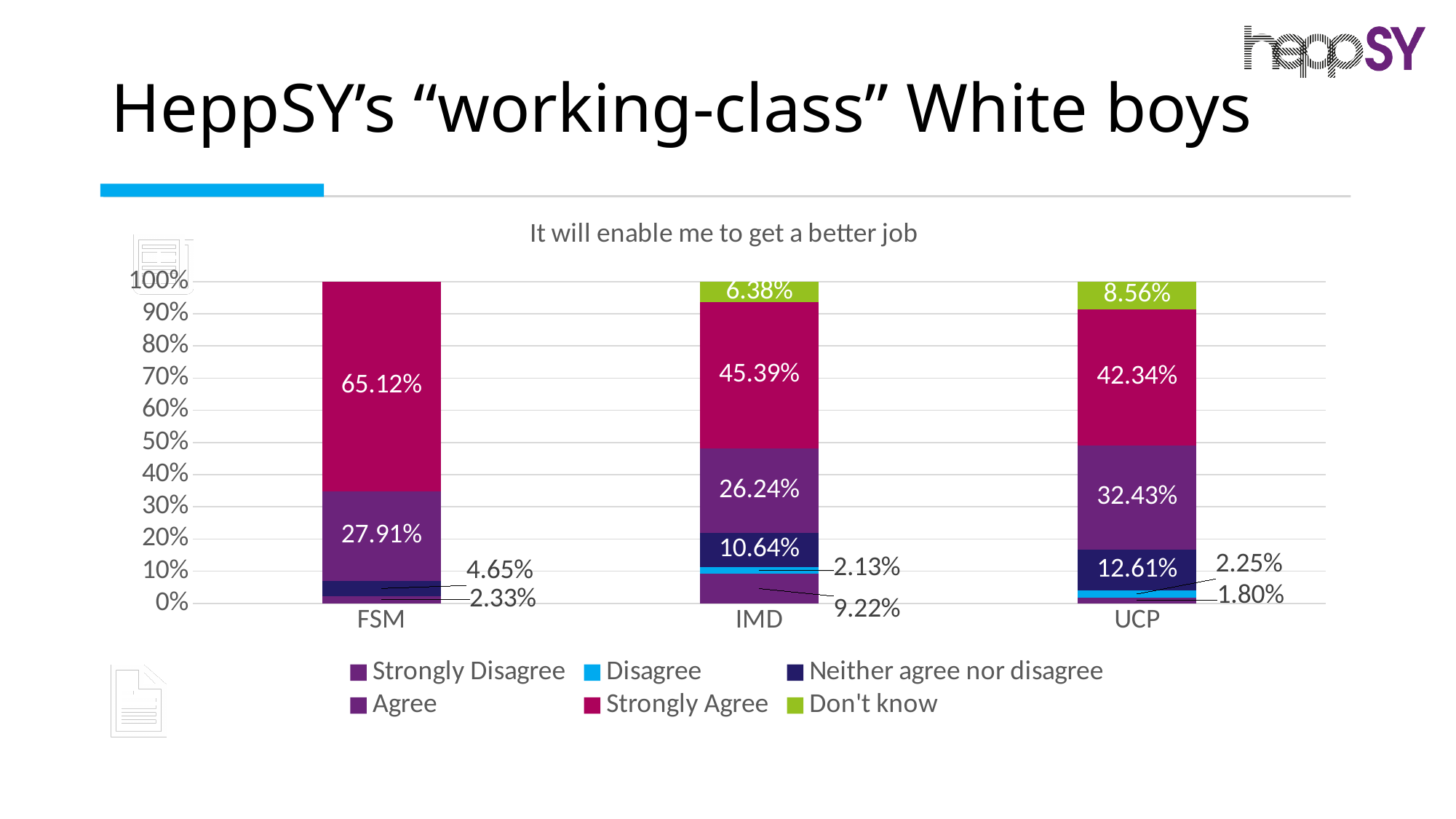
Which category has the highest Strongly Agree value? FSM How many categories are shown on the x axis? 3 What is the Neither agree nor disagree value for UCP? 12.61% What kind of chart is shown on the slide? Stacked bar chart What is the difference between the Strongly Agree values for IMD and UCP? 3.05% Which category has the lowest Agree value? IMD What is the Strongly Disagree value for IMD? 9.22% How many series does the legend list? 6 What is the Agree value for UCP? 32.43% What is the Don't know value for IMD? 6.38% What is the Strongly Agree value for FSM? 65.12% Is the Don't know value larger for IMD or UCP? UCP